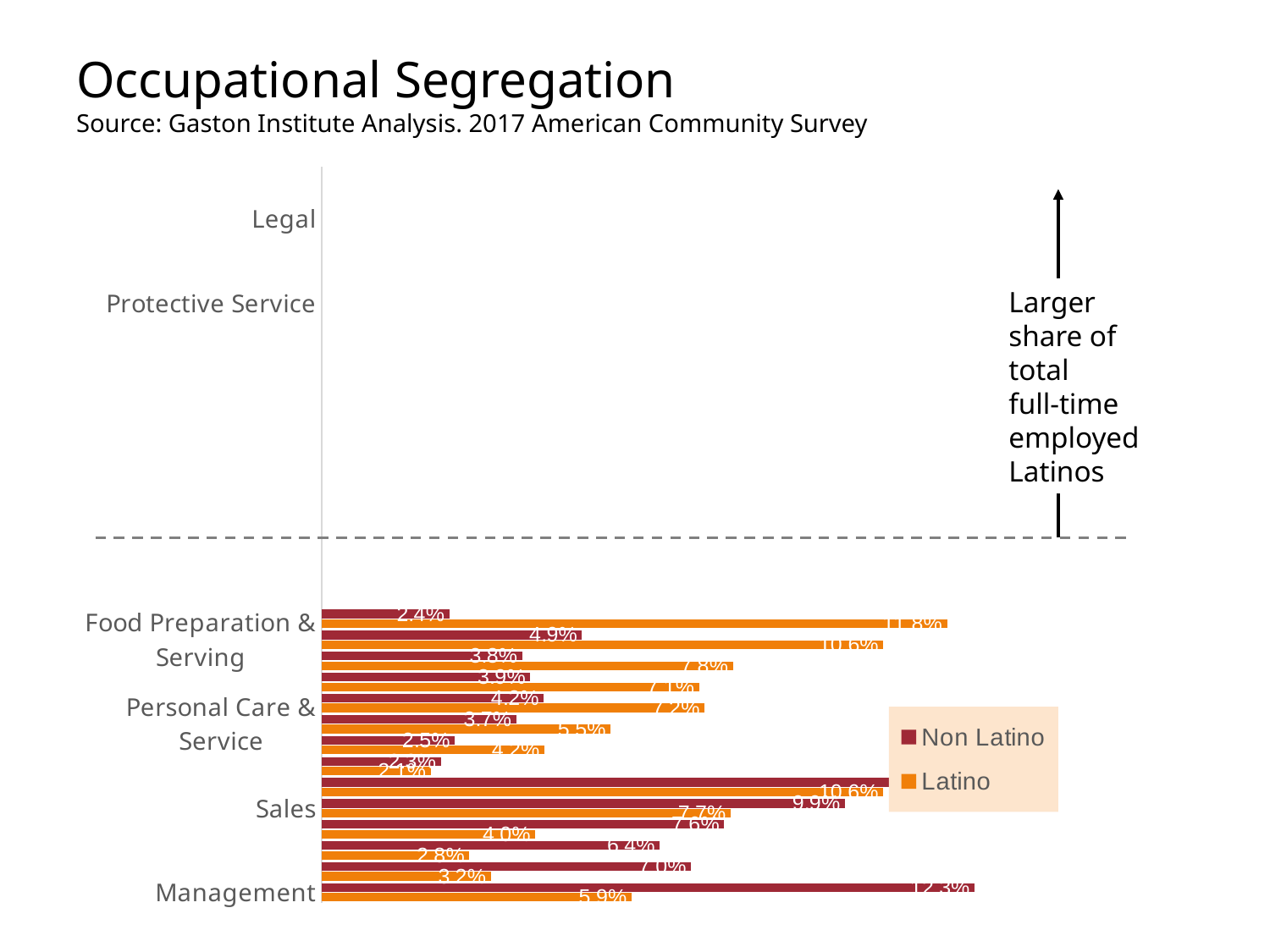
What is the Latino value for Personal Care & Service? 5.5% What is the difference between the Non Latino and Latino values for Management? 6.4 percentage points What is the Latino value for Sales? 7.7% What kind of chart is shown on the slide? Bar chart What is the title of the chart on the slide? Occupational Segregation How many series does the legend list? 2 What is the Non Latino value for Management? 12.3% What is the Latino value for Management? 5.9% For Personal Care & Service, which series has the larger value, Non Latino or Latino? Latino What is the Non Latino value for Sales? 9.9% What are the two series named in the legend? Non Latino and Latino For Management, which series has the larger value, Non Latino or Latino? Non Latino